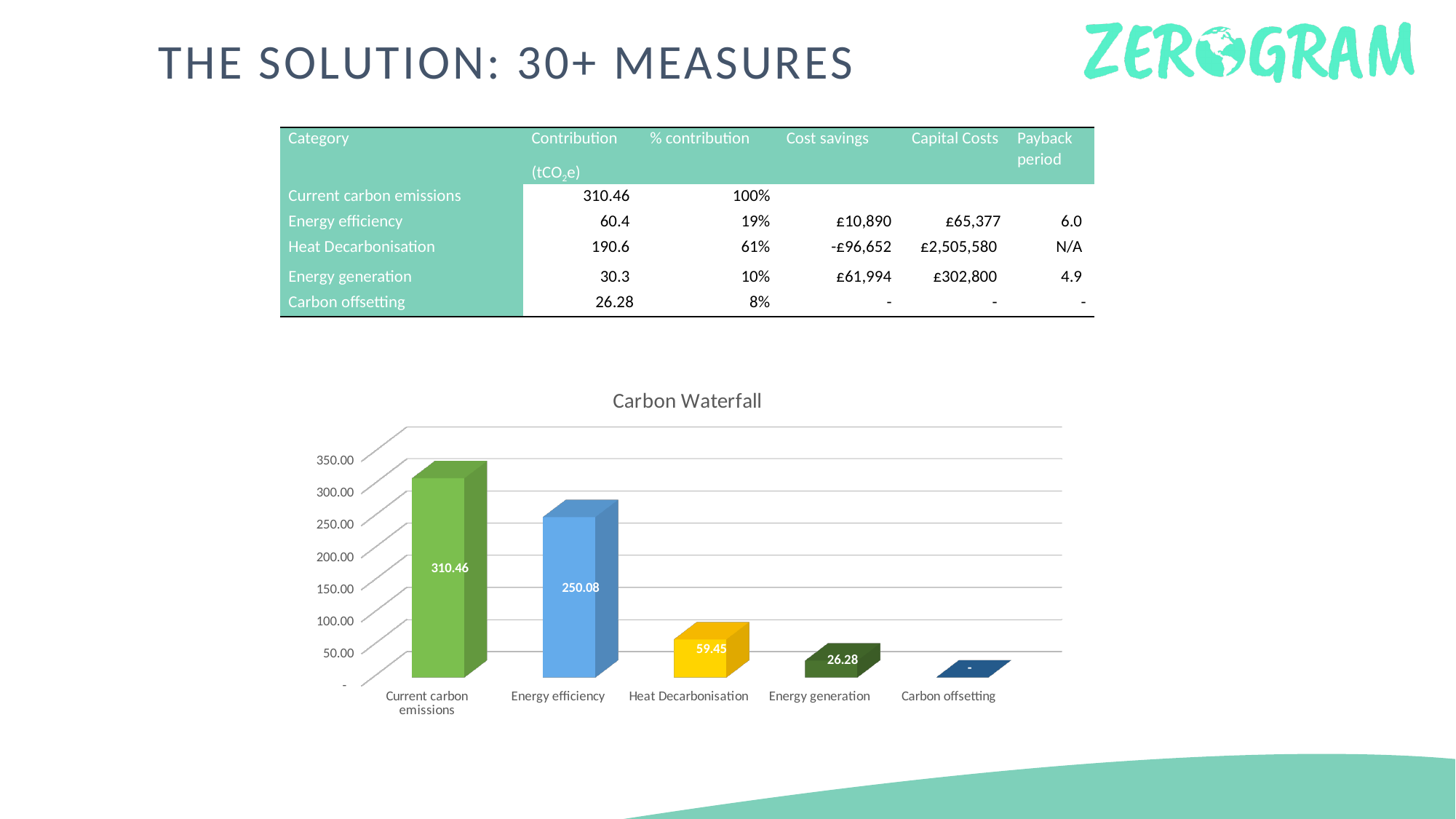
Do the values in the Carbon Waterfall chart rise or fall from left to right along the x axis? fall What type of chart is the Carbon Waterfall chart? bar chart In the Carbon Waterfall chart, what is the value for Energy generation? 26.28 In the Carbon Waterfall chart, what is the value for Heat Decarbonisation? 59.45 In the Carbon Waterfall chart, what is the value for Energy efficiency? 250.08 In the Carbon Waterfall chart, what is the value for Current carbon emissions? 310.46 In the Carbon Waterfall chart, which is larger: the value for Heat Decarbonisation or the value for Energy generation? Heat Decarbonisation What is the title of the chart on the slide? Carbon Waterfall In the Carbon Waterfall chart, what is the difference between the values for Heat Decarbonisation and Energy generation? 33.17 Which category has the highest value in the Carbon Waterfall chart? Current carbon emissions In the Carbon Waterfall chart, what is the difference between the values for Current carbon emissions and Energy efficiency? 60.38 How many categories are shown on the x axis of the Carbon Waterfall chart? 5